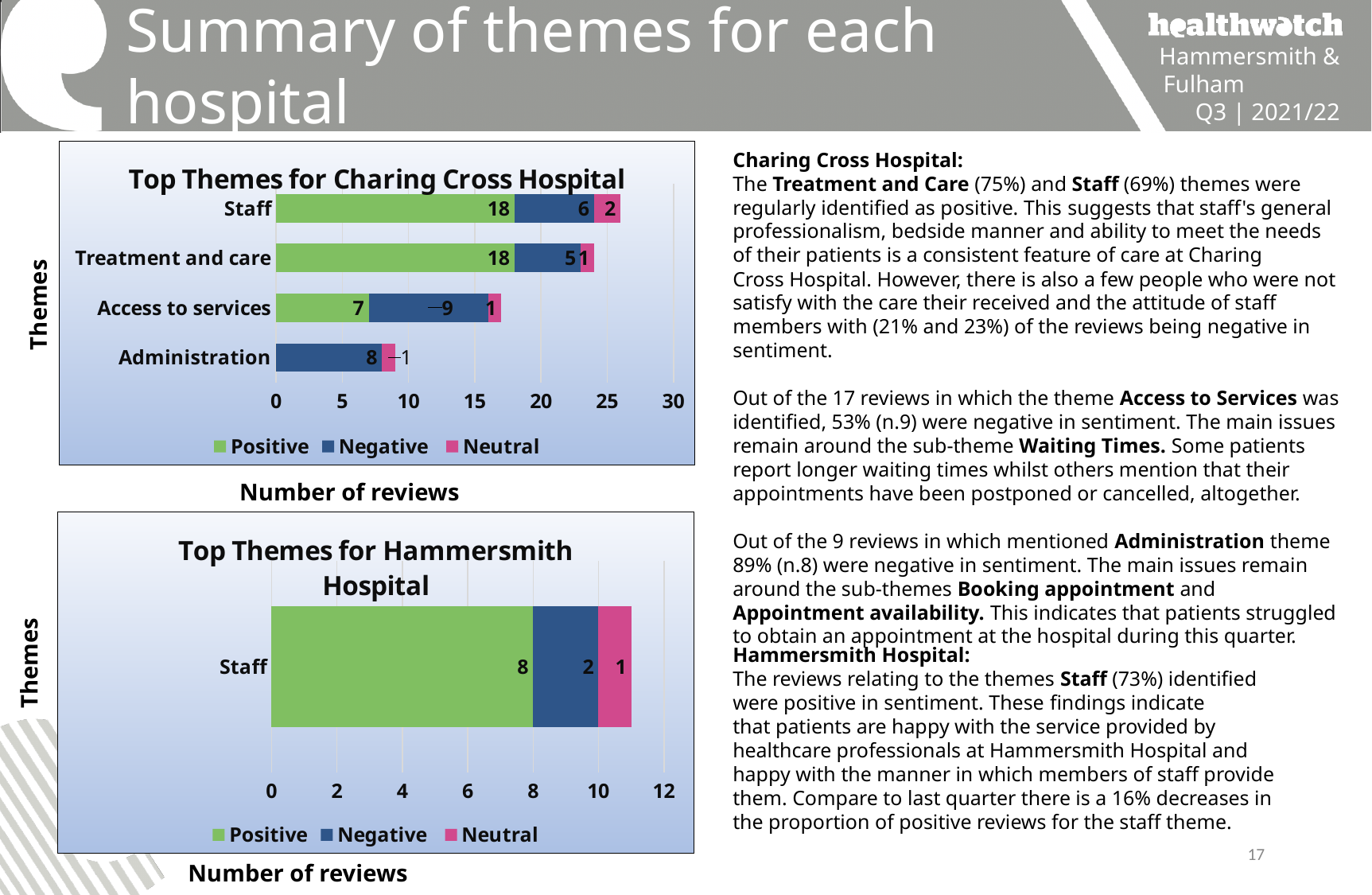
In the Top Themes for Charing Cross Hospital chart, which is larger for Access to services: the Positive value or the Negative value? Negative In the Top Themes for Charing Cross Hospital chart, what is the Negative value for Access to services? 9 In the Top Themes for Charing Cross Hospital chart, what is the total number of reviews for Staff across all three sentiments? 26 How many themes are shown in the Top Themes for Charing Cross Hospital chart? 4 In the Top Themes for Hammersmith Hospital chart, what is the total number of reviews for Staff? 11 In the Top Themes for Charing Cross Hospital chart, what is the Negative value for Administration? 8 In the Top Themes for Charing Cross Hospital chart, what is the Positive value for Staff? 18 In the Top Themes for Charing Cross Hospital chart, which theme has the lowest total number of reviews? Administration In the Top Themes for Charing Cross Hospital chart, what is the total number of reviews for Access to services across all three sentiments? 17 In the Top Themes for Hammersmith Hospital chart, what is the Positive value for Staff? 8 How many series does the legend list in the Top Themes for Hammersmith Hospital chart? 3 In the Top Themes for Charing Cross Hospital chart, what is the difference between the Negative values for Staff and Treatment and care? 1